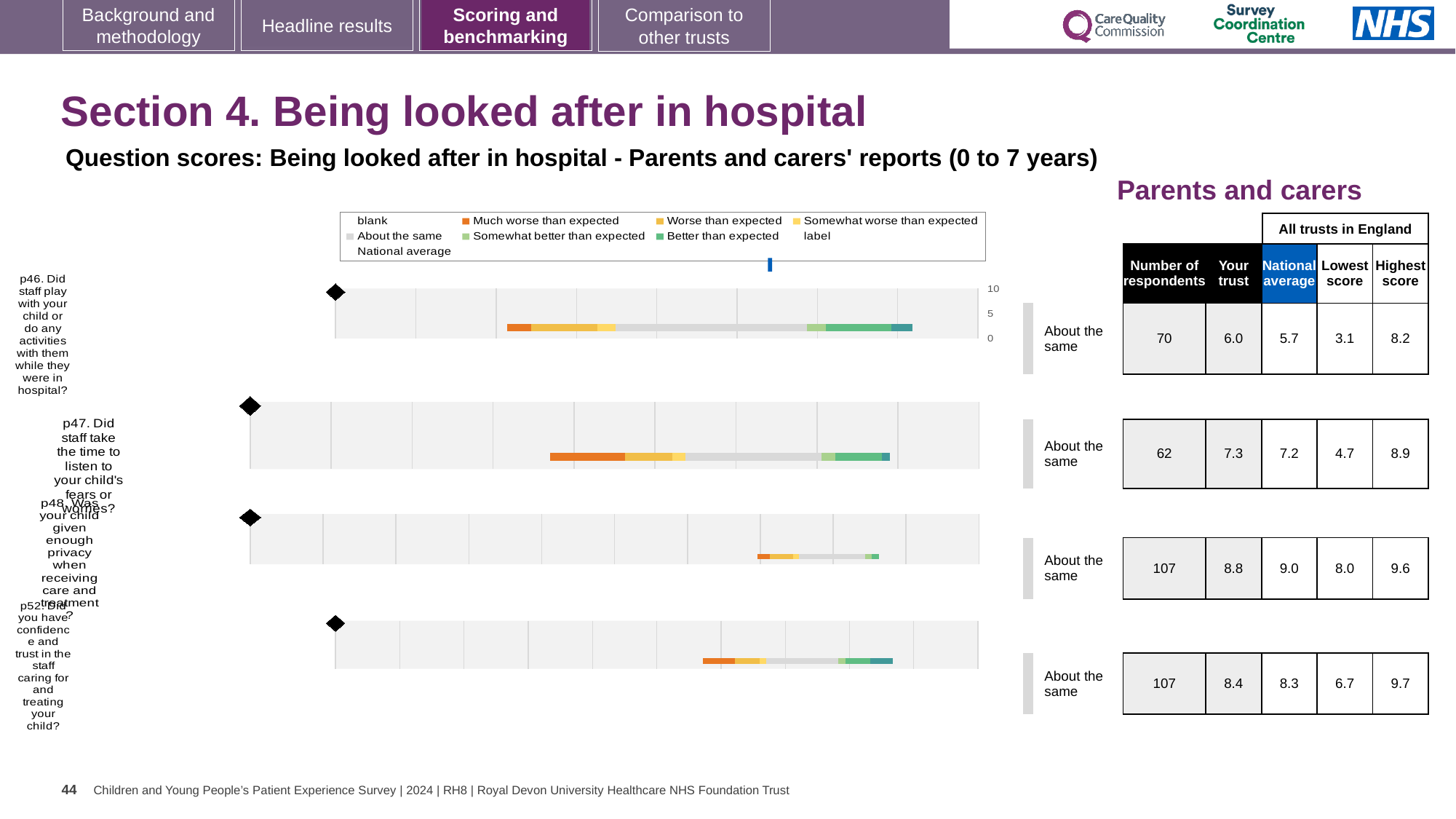
How many questions (bars) are plotted in the chart? 4 In the table beside the chart, what is the difference between the highest score and the lowest score for p52 (Did you have confidence and trust in the staff caring for and treating your child)? 3.0 In the table beside the chart, what is the 'Your trust' score for p47 (Did staff take the time to listen to your child's fears or worries)? 7.3 In the table beside the chart, what is the national average for p48 (Was your child given enough privacy when receiving care and treatment)? 9.0 In the table beside the chart, which question has the lowest 'Your trust' score? p46. Did staff play with your child or do any activities with them while they were in hospital? What is the benchmark category shown next to the bar for p46 (Did staff play with your child or do any activities with them while they were in hospital)? About the same In the table beside the chart, is the 'Your trust' score for p46 higher or lower than the national average? higher In the legend, what colour represents 'Much worse than expected'? orange In the table beside the chart, how many respondents answered p47? 62 In the table beside the chart, which question has the highest 'Your trust' score? p48. Was your child given enough privacy when receiving care and treatment? What kind of chart is used to show the question scores for Being looked after in hospital? bar chart What is the title of the table to the right of the chart? Parents and carers